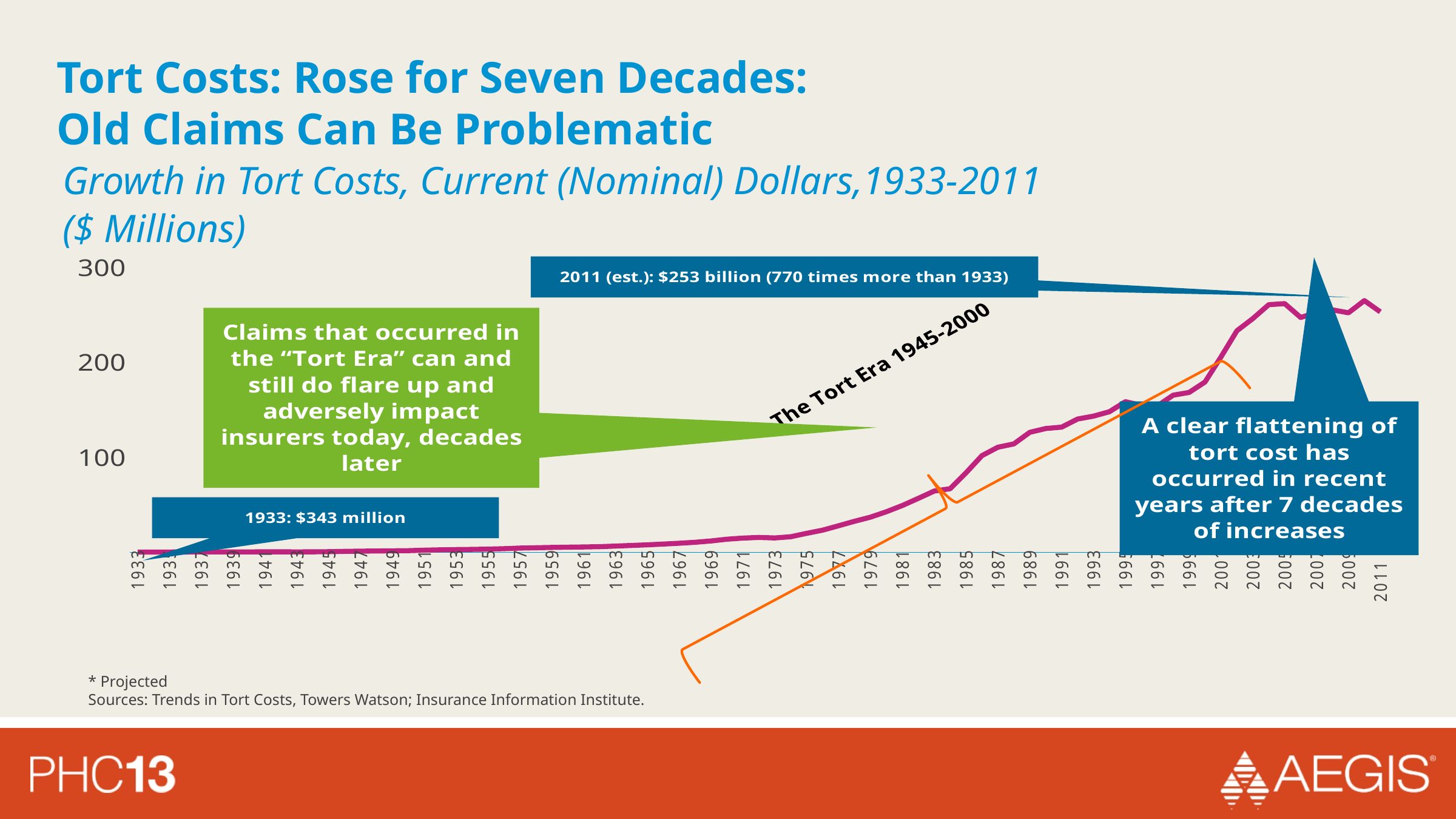
What kind of chart is shown on the slide? line chart Is the value for 1983 greater or less than 100? less What was the tort cost in 1933 according to the callout on the chart? $343 million According to the chart callout, how many times larger is the 2011 estimate than the 1933 value? 770 times Which year has the lowest tort cost on the chart? 1933 Is the value for 1995 greater or less than 200? less What is the estimated tort cost for 2011 according to the callout on the chart? $253 billion Is the value for 1973 greater or less than 100? less Overall, do tort costs rise or fall from 1933 to 2011 along the x axis? rise Which years does the chart label as "The Tort Era"? 1945-2000